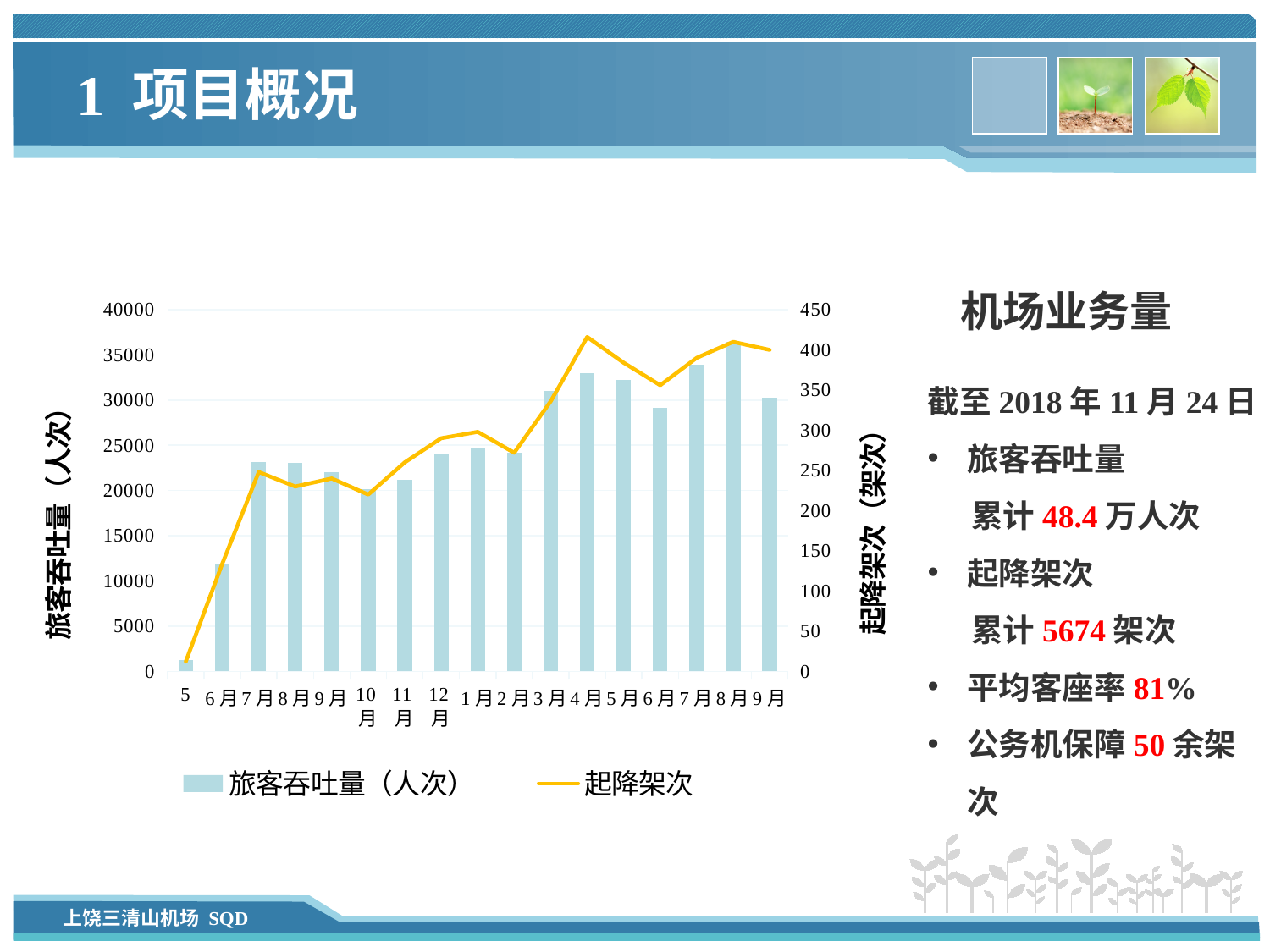
Which has the taller 旅客吞吐量 bar, 4月 or the second 6月? 4月 How many months are plotted along the x axis? 17 Is the 旅客吞吐量 bar for the first 6月 greater or less than 10000? greater Is the 起降架次 value for 10月 greater or less than 250? less Which month has the tallest 旅客吞吐量 bar? 8月 (the second 8月) Is the 旅客吞吐量 bar for 4月 greater or less than 30000? greater Does the 起降架次 line rise or fall from the first 5月 to the first 7月? rise How many series does the legend list? 2 Which month has the lowest point on the 起降架次 line? 5 (the first category) Which month has the shortest 旅客吞吐量 bar? 5 (the first category) What is the title of the left vertical axis? 旅客吞吐量（人次） What kind of chart is shown on the slide? A combined bar and line chart